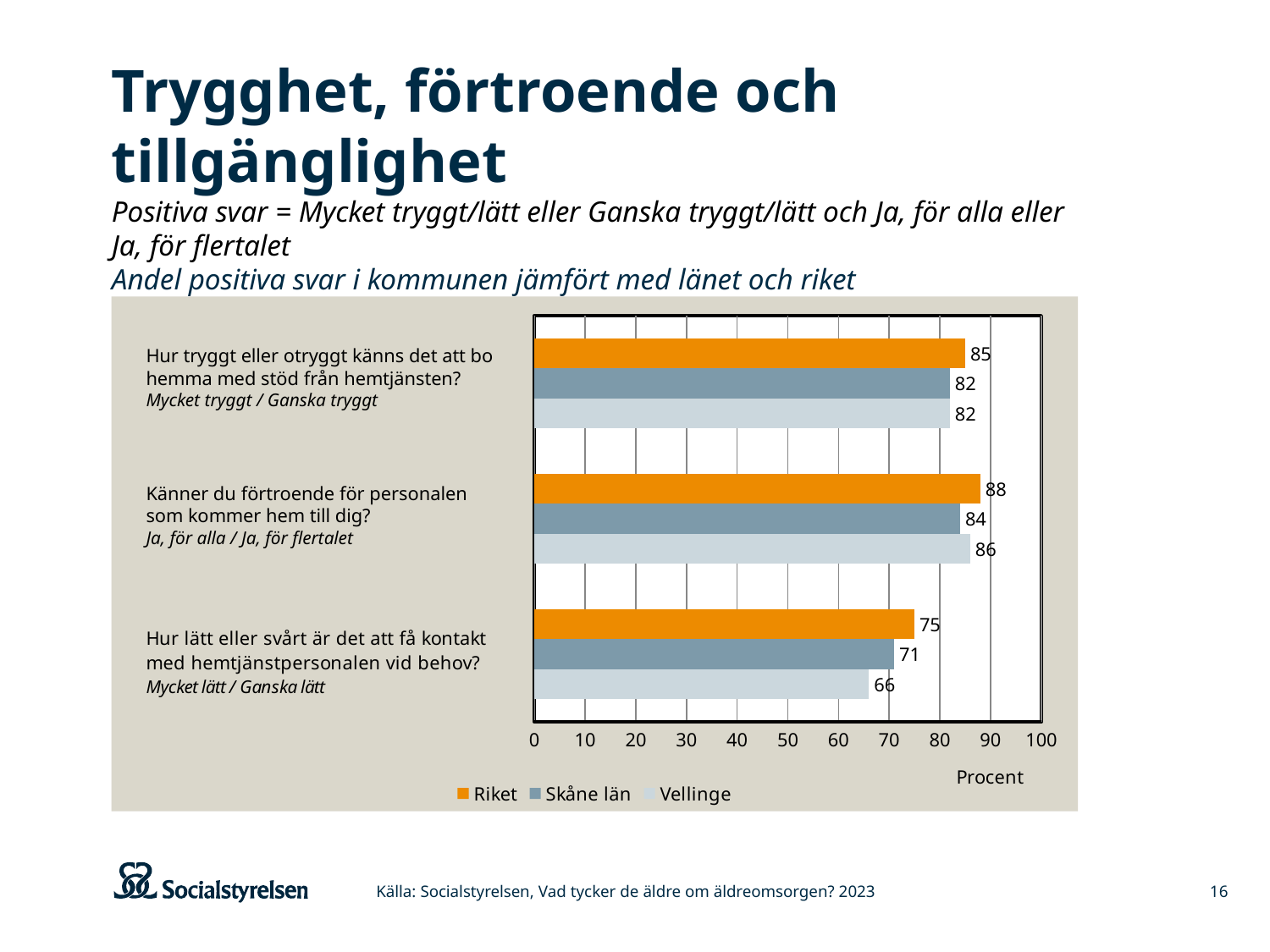
How many series does the legend list? 3 Which colour represents Riket in the legend? Orange Which series has the highest value on the question 'Känner du förtroende för personalen som kommer hem till dig?' Riket Which series has the lowest value on the question 'Hur lätt eller svårt är det att få kontakt med hemtjänstpersonalen vid behov?' Vellinge What is the difference between Riket and Vellinge on the question 'Hur lätt eller svårt är det att få kontakt med hemtjänstpersonalen vid behov?' 9 What is the value for Skåne län on the question 'Känner du förtroende för personalen som kommer hem till dig?' 84 What is the value for Vellinge on the question 'Hur lätt eller svårt är det att få kontakt med hemtjänstpersonalen vid behov?' 66 Which is larger on the question 'Känner du förtroende för personalen som kommer hem till dig?': Vellinge or Skåne län? Vellinge What is the unit label shown on the x axis? Procent How many questions (categories) are shown in the chart? 3 What kind of chart is shown on the slide? Bar chart What is the value for Riket on the question 'Hur tryggt eller otryggt känns det att bo hemma med stöd från hemtjänsten?' 85